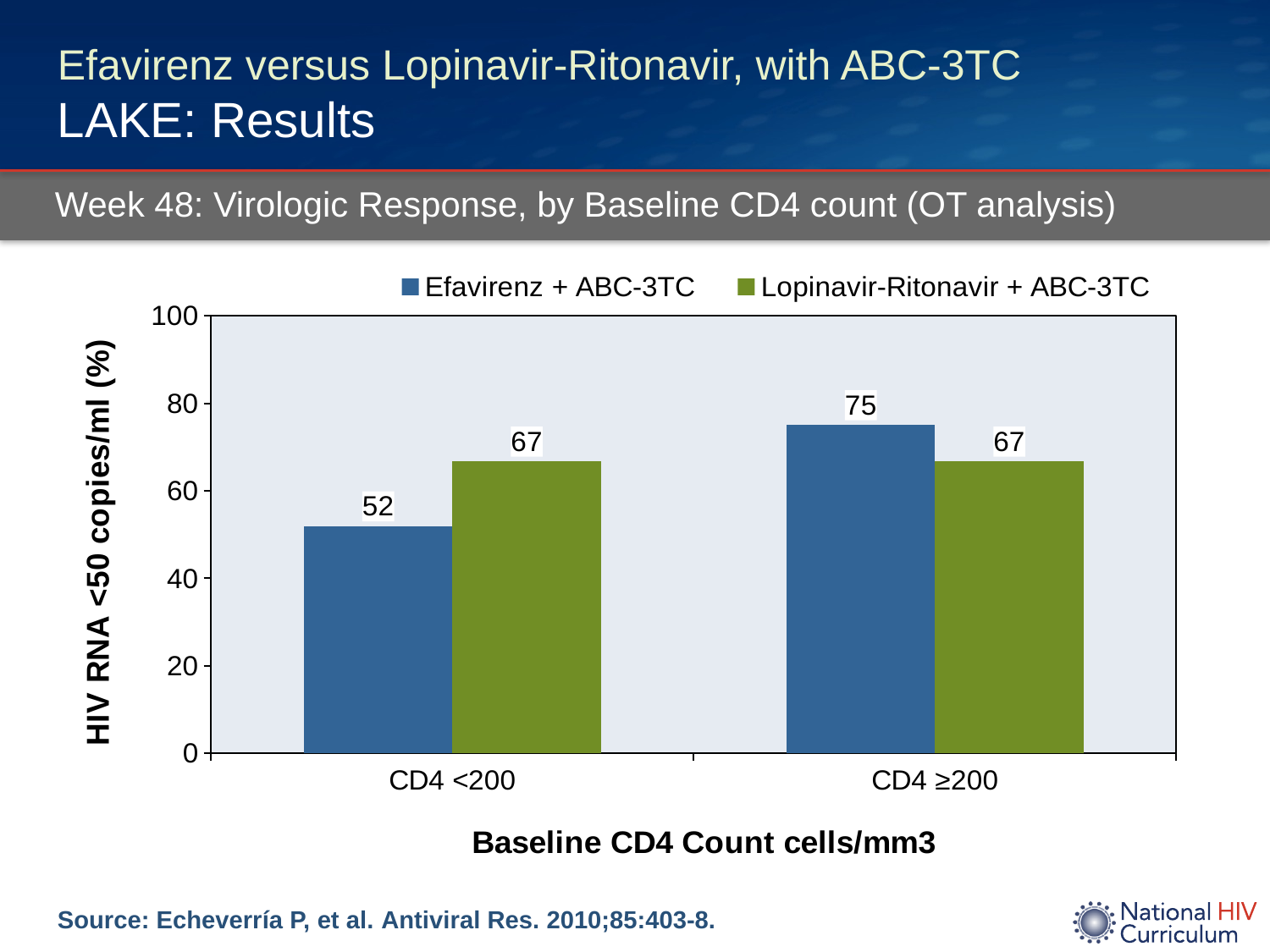
What kind of chart is shown on the slide? bar chart What is the value for Efavirenz + ABC-3TC in the CD4 ≥200 group? 75 What is the value for Lopinavir-Ritonavir + ABC-3TC in the CD4 ≥200 group? 67 In the CD4 <200 group, which series has the larger value, Efavirenz + ABC-3TC or Lopinavir-Ritonavir + ABC-3TC? Lopinavir-Ritonavir + ABC-3TC Is the value for Efavirenz + ABC-3TC in the CD4 ≥200 group greater or less than 60? greater Which series has the highest value in the CD4 ≥200 group? Efavirenz + ABC-3TC What is the difference between the Lopinavir-Ritonavir + ABC-3TC and Efavirenz + ABC-3TC values in the CD4 <200 group? 15 What is the value for Efavirenz + ABC-3TC in the CD4 <200 group? 52 Which bar has the lowest value on the chart? Efavirenz + ABC-3TC, CD4 <200 What is the y-axis label of the chart? HIV RNA <50 copies/ml (%) How many baseline CD4 count categories are shown on the x axis? 2 How many series does the legend list? 2